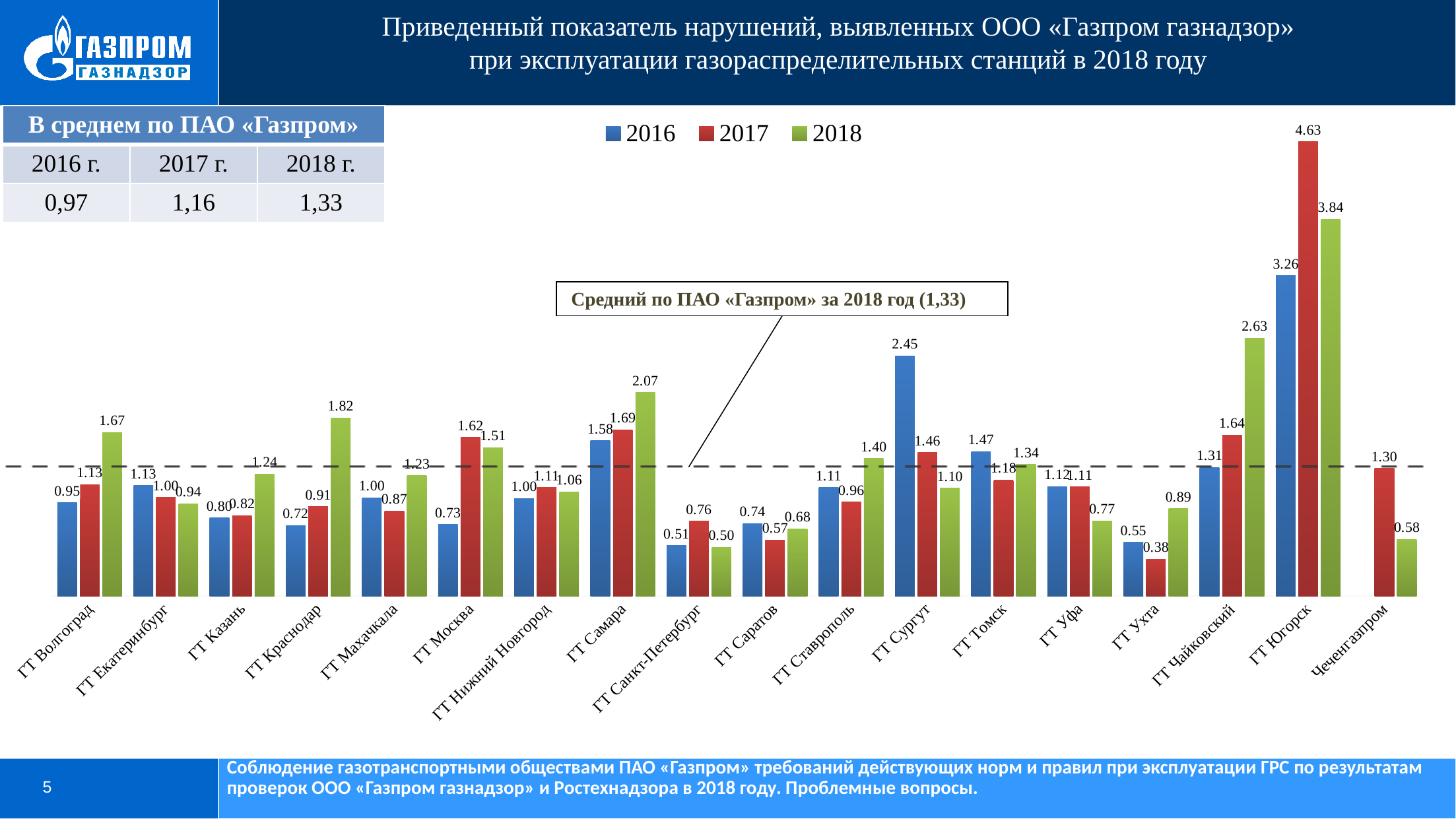
What is the 2017 value for ГТ Москва? 1.62 What is the difference between the 2017 and 2018 values for ГТ Югорск? 0.79 Which is larger for ГТ Краснодар: the 2017 value or the 2018 value? 2018 Which category has the highest 2017 value? ГТ Югорск What is the difference between the 2018 and 2016 values for ГТ Чайковский? 1.32 What kind of chart is shown on the slide? bar chart What value does the dashed horizontal line on the chart represent, according to the callout? 1,33 How many categories are shown on the x axis? 18 How many series does the legend list? 3 Which category has the lowest 2017 value? ГТ Ухта What is the 2018 value for ГТ Самара? 2.07 What is the 2016 value for ГТ Сургут? 2.45